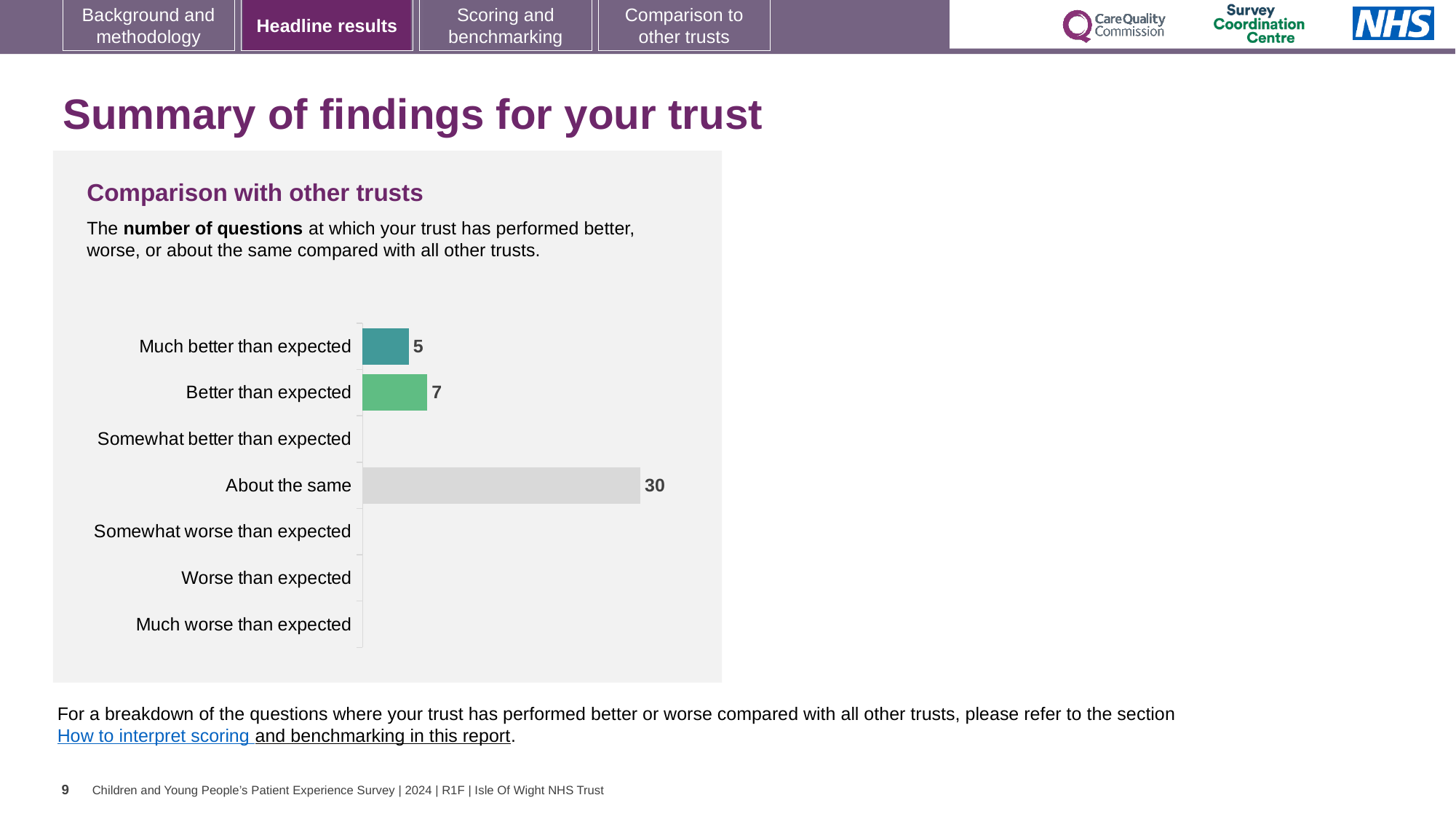
What is the title of the chart? Comparison with other trusts What is the value for 'Much better than expected'? 5 Which category has the highest value? About the same What is the difference between the values for 'Better than expected' and 'Much better than expected'? 2 What is the difference between the values for 'About the same' and 'Better than expected'? 23 Which is larger, the value for 'Better than expected' or the value for 'Much better than expected'? Better than expected What is the total of the values shown for 'Much better than expected', 'Better than expected' and 'About the same'? 42 What colour is the bar for 'About the same'? Grey What is the value for 'About the same'? 30 What kind of chart is shown on the slide? Bar chart How many categories are listed on the chart's axis? 7 What is the value for 'Better than expected'? 7